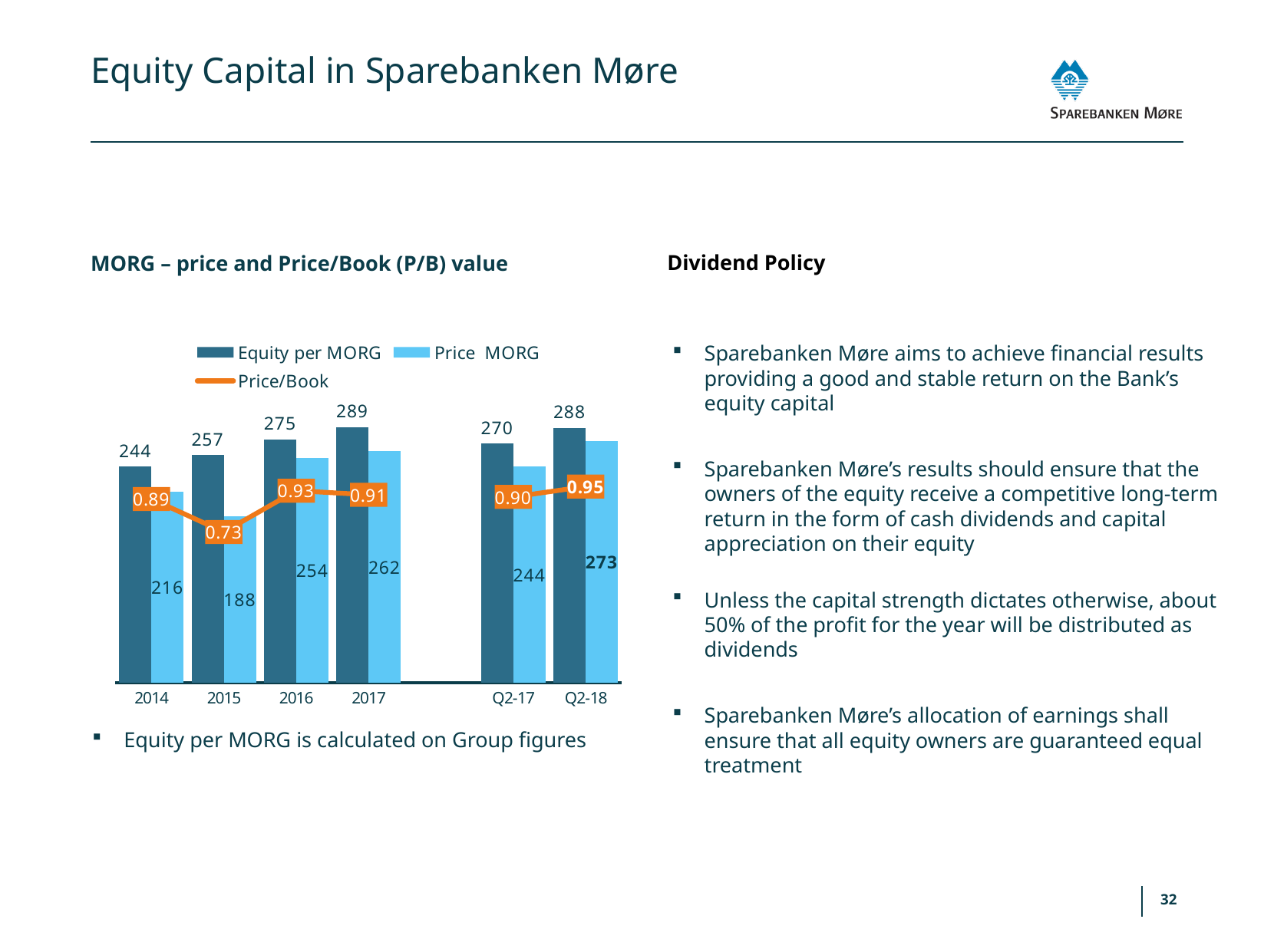
Which period has the highest Equity per MORG value? 2017 Which period has the lowest Price/Book value? 2015 How many series does the chart legend list? 3 What kind of chart is used to show Equity per MORG and Price MORG? Bar chart How many periods are shown on the x axis of the chart? 6 What is the Price MORG value for 2015? 188 Which is larger, the Price MORG value for 2016 or for Q2-17? 2016 What is the difference between Equity per MORG and Price MORG in 2015? 69 Does the Equity per MORG value rise or fall from 2014 to 2017? Rise What is the Price/Book value for Q2-18? 0.95 What is the Equity per MORG value for 2017? 289 What is the title of the chart? MORG – price and Price/Book (P/B) value